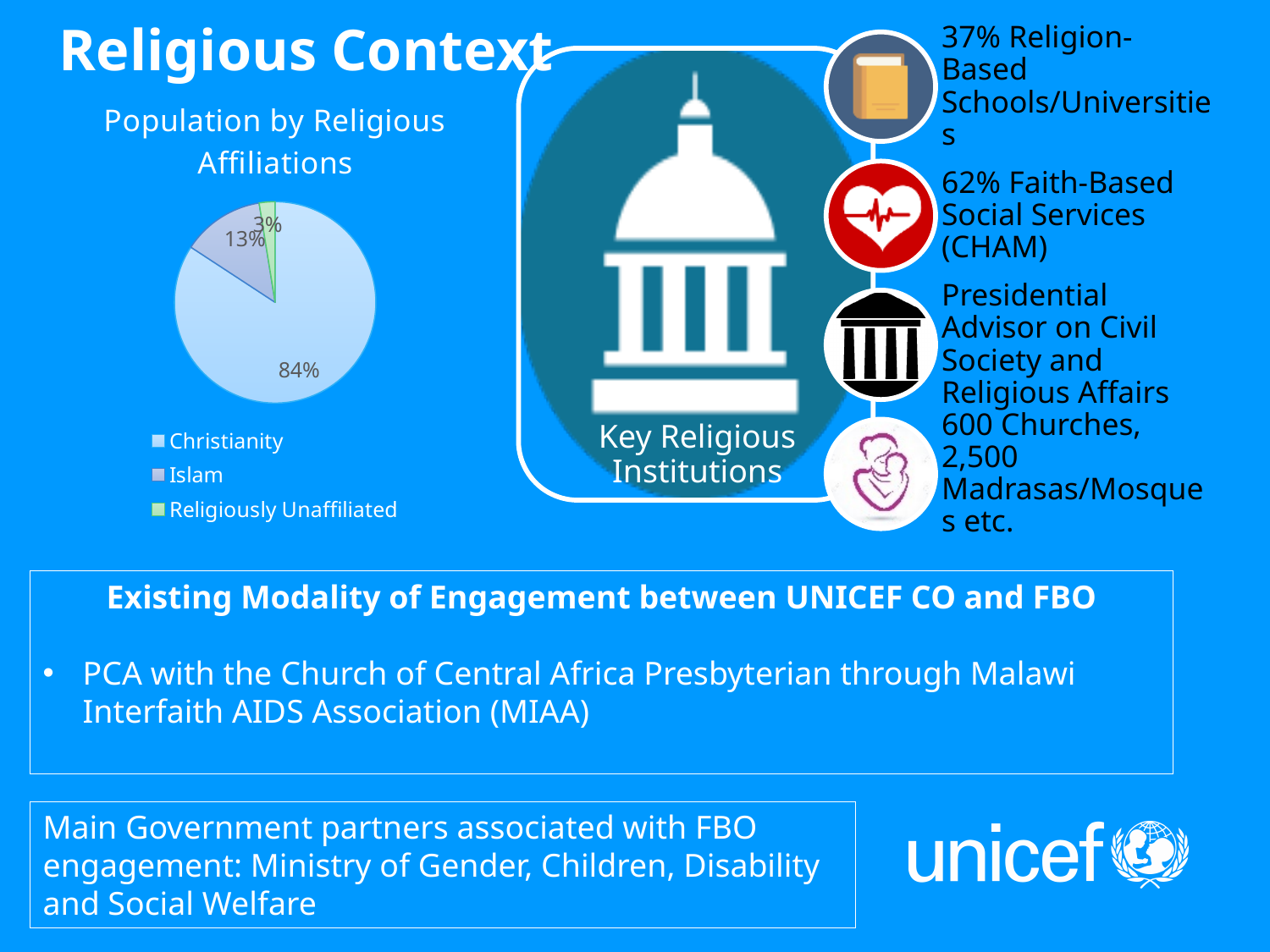
What type of chart is shown under the title 'Population by Religious Affiliations'? pie chart Which category has the largest slice in the pie chart? Christianity What share of the population is Christianity in the pie chart? 84% What is the difference in percentage points between the Islam and Religiously Unaffiliated slices? 10 What share of the population is Religiously Unaffiliated in the pie chart? 3% What is the title of the pie chart? Population by Religious Affiliations Which legend entry is shown in green in the pie chart? Religiously Unaffiliated Which slice is larger in the pie chart, Islam or Religiously Unaffiliated? Islam What is the difference in percentage points between the Christianity and Islam slices? 71 What share of the population is Islam in the pie chart? 13% How many categories does the pie chart show? 3 Which category has the smallest slice in the pie chart? Religiously Unaffiliated